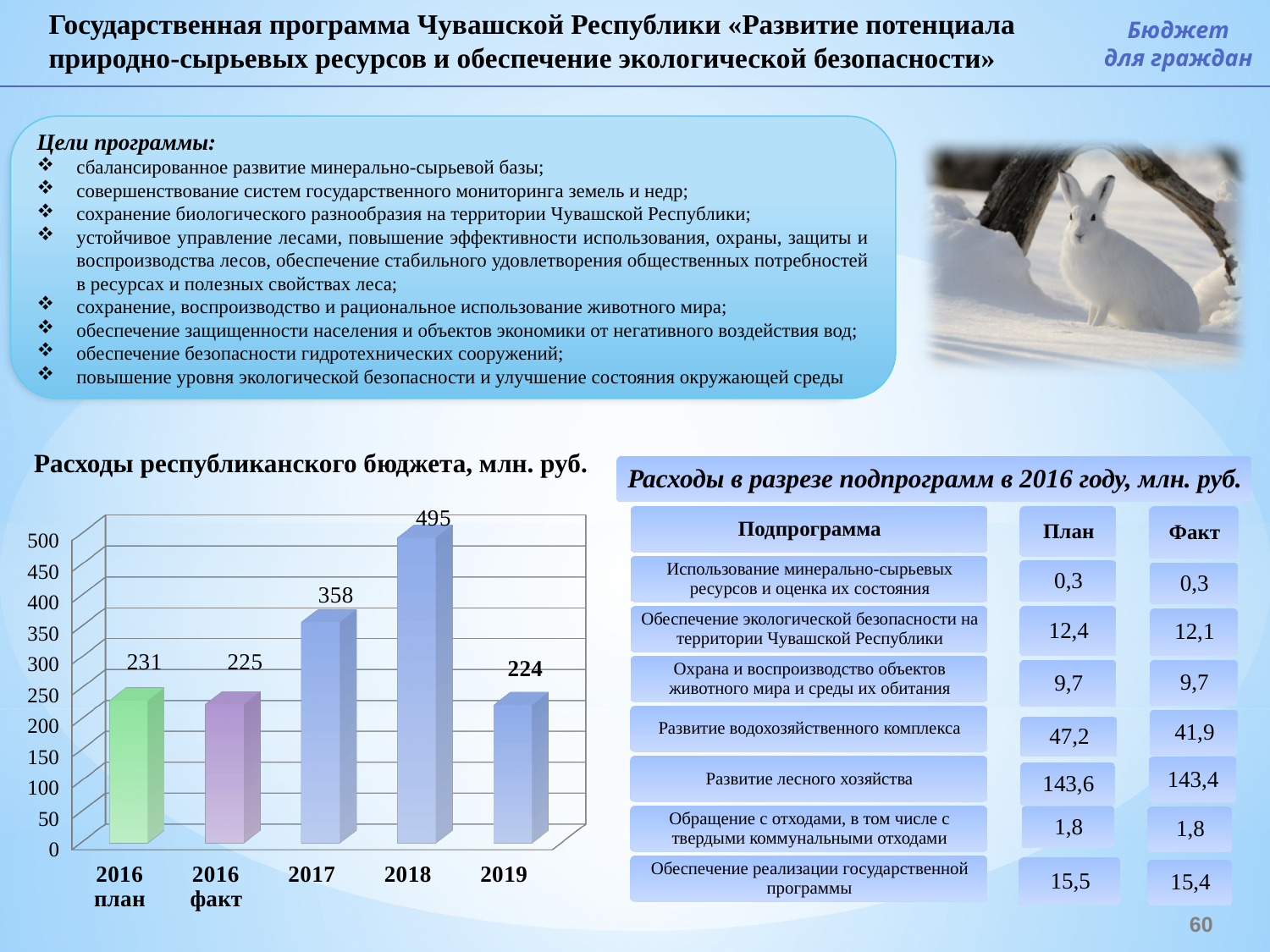
Which category has the highest value in the chart 'Расходы республиканского бюджета, млн. руб.'? 2018 What is the value for 2019 in the chart 'Расходы республиканского бюджета, млн. руб.'? 224 How many bars are shown in the chart 'Расходы республиканского бюджета, млн. руб.'? 5 What is the value for '2016 факт' in the chart 'Расходы республиканского бюджета, млн. руб.'? 225 In the chart 'Расходы республиканского бюджета, млн. руб.', which is larger: the value for 2017 or the value for 2019? 2017 Which category has the lowest value in the chart 'Расходы республиканского бюджета, млн. руб.'? 2019 In the chart 'Расходы республиканского бюджета, млн. руб.', what is the difference between the values for 2018 and 2017? 137 What is the value for 2018 in the chart 'Расходы республиканского бюджета, млн. руб.'? 495 What is the value for '2016 план' in the chart 'Расходы республиканского бюджета, млн. руб.'? 231 In the chart 'Расходы республиканского бюджета, млн. руб.', does the value rise or fall from 2018 to 2019? fall In the chart 'Расходы республиканского бюджета, млн. руб.', what is the difference between '2016 план' and '2016 факт'? 6 What type of chart is 'Расходы республиканского бюджета, млн. руб.'? bar chart